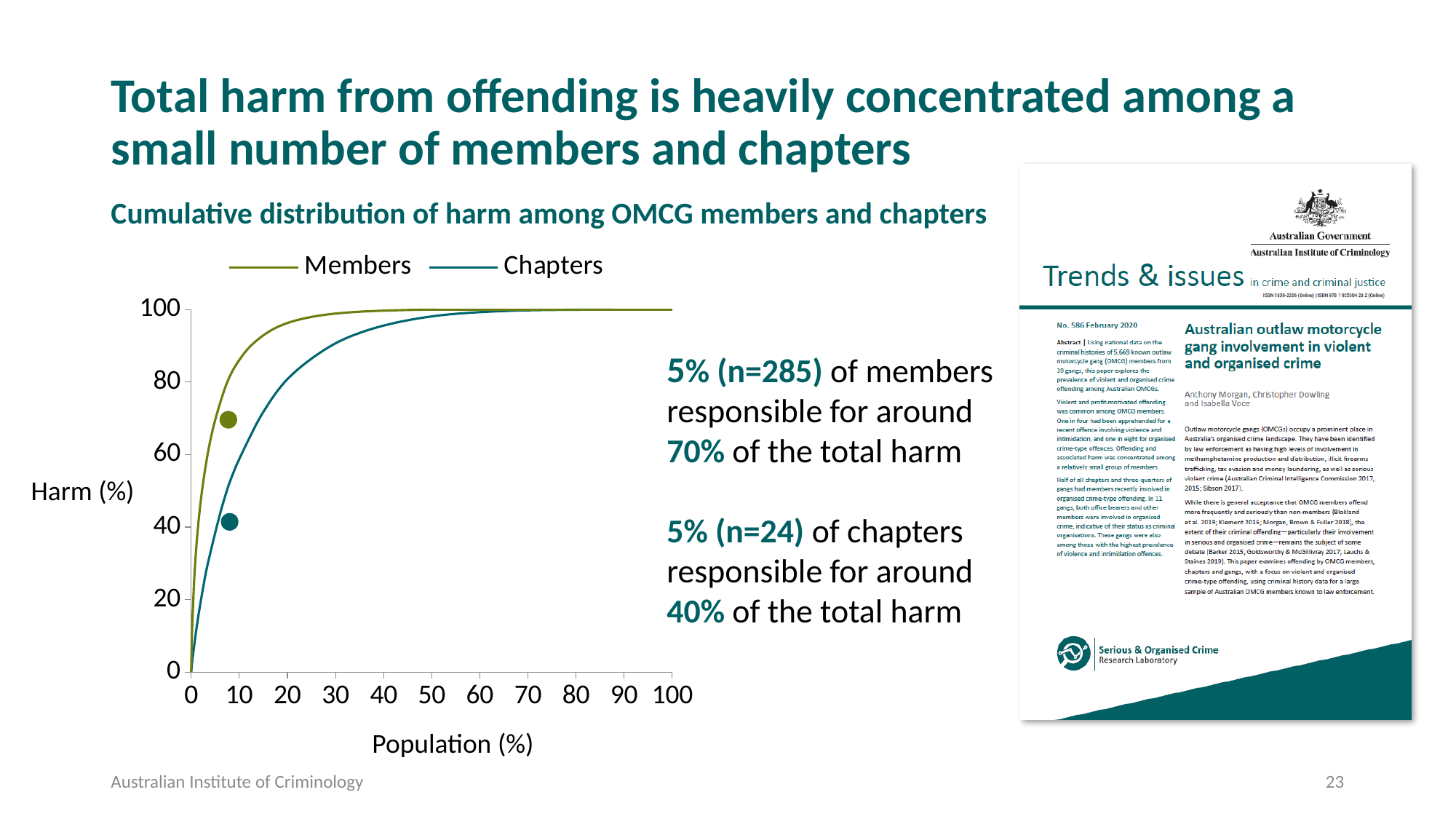
What kind of chart is shown on the slide? Line chart Is the Members value at 10% population greater or less than 60? greater At 10% of the population, which series shows the higher cumulative harm, Members or Chapters? Members Which series reaches 100% harm at a smaller population percentage, Members or Chapters? Members Is the Chapters value at 10% population greater or less than 60? less Is the Members value at 20% population greater or less than 80? greater Do the harm values rise or fall as population percentage increases along the x axis? Rise How many series does the chart legend list? 2 What are the two series named in the chart legend? Members and Chapters What is the label on the y axis of the chart? Harm (%) How many tick labels are shown on the x axis of the chart? 11